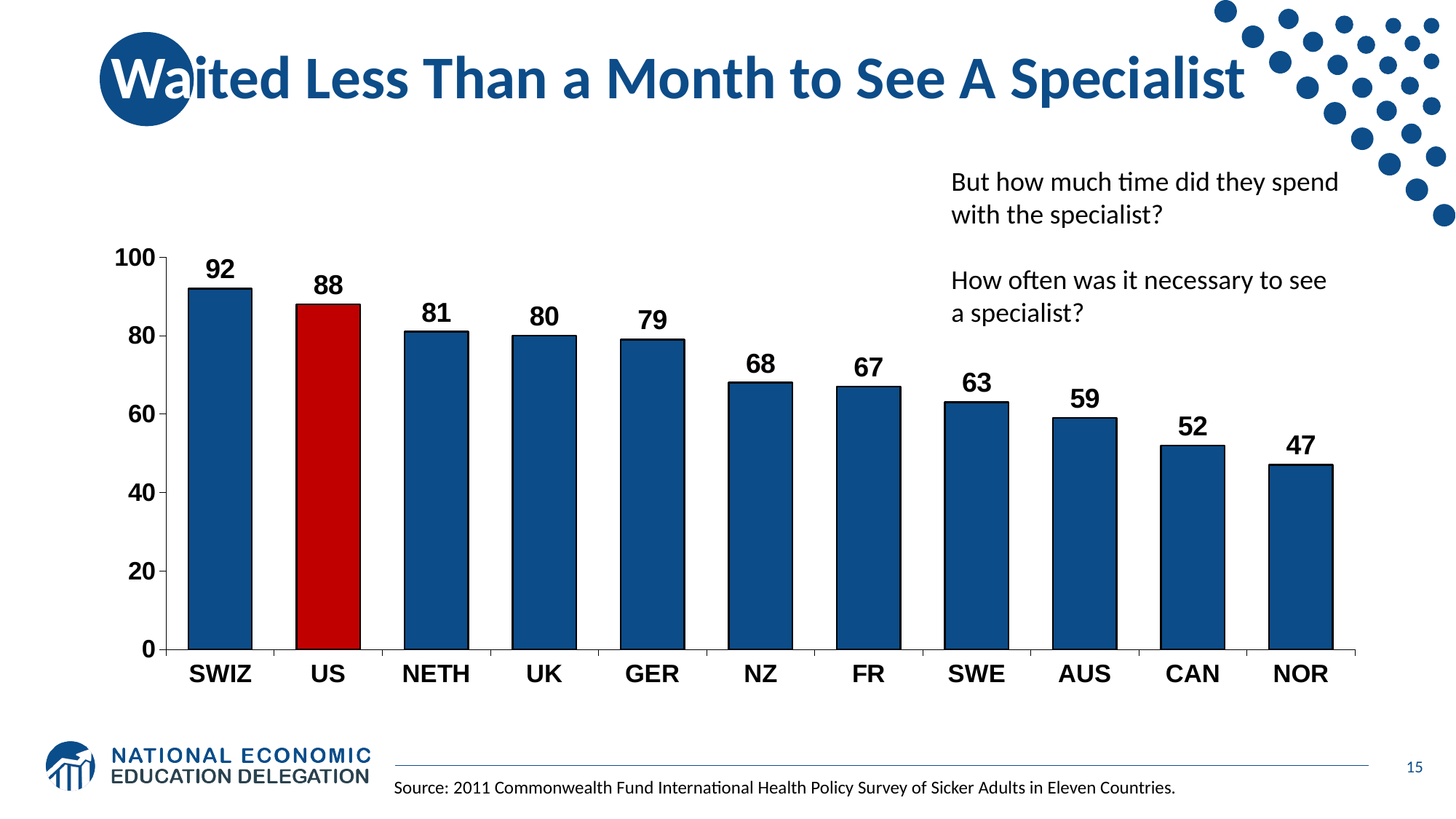
What kind of chart is shown on the slide? bar chart What is the difference between the values for SWIZ and NOR? 45 What is the value for CAN? 52 What is the value for GER? 79 How many countries are shown on the chart? 11 Which country has the lowest value? NOR What is the value for the US? 88 Is the value for AUS greater or less than 60? less Which is larger, the value for NZ or the value for SWE? NZ Which country has the highest value? SWIZ Which bar is coloured red rather than blue? US What is the difference between the values for US and NETH? 7